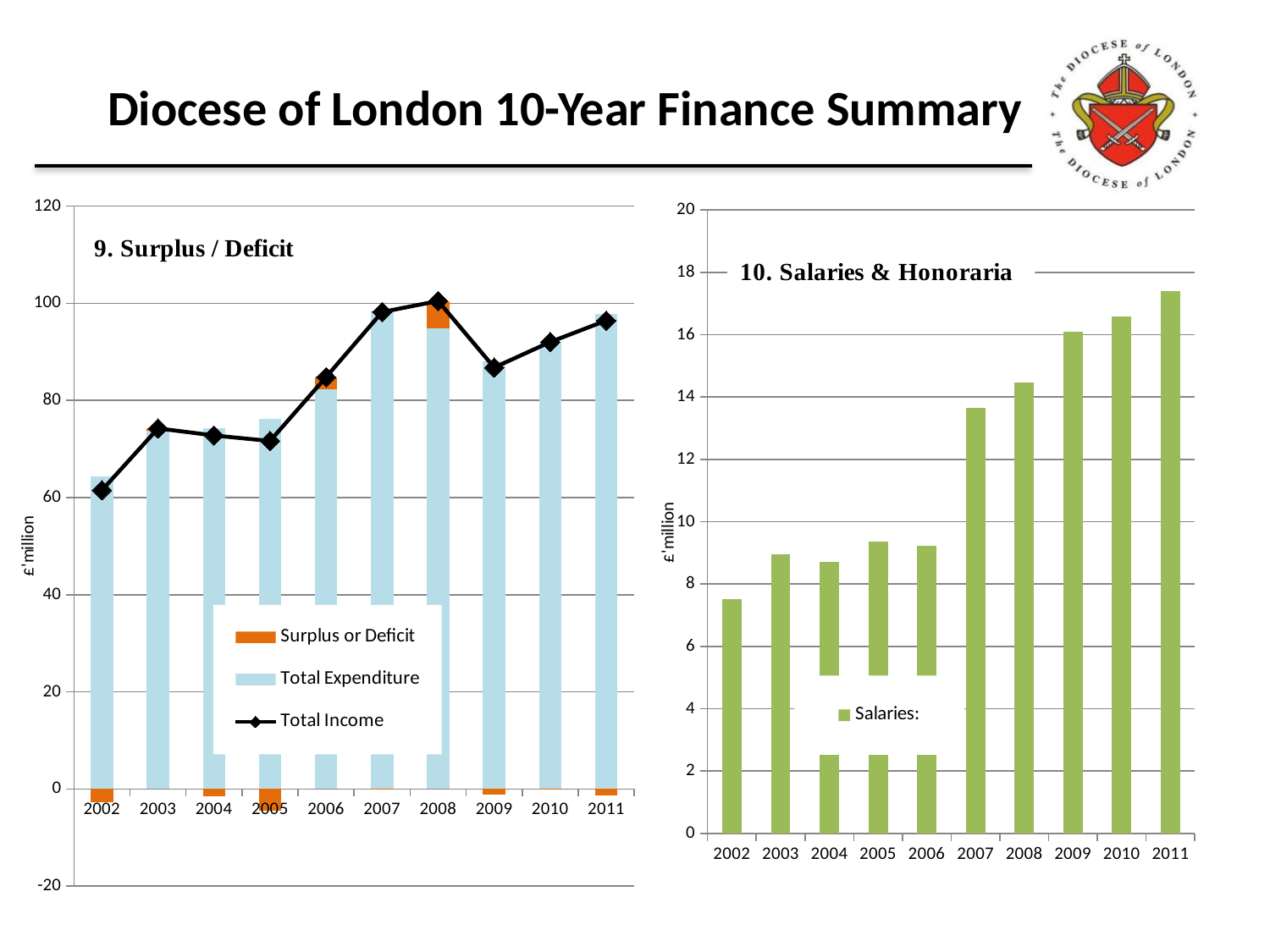
In the '10. Salaries & Honoraria' chart, is the value for 2007 greater or less than 12? greater What kind of chart is '10. Salaries & Honoraria'? bar chart How many years are shown on the x axis of the '10. Salaries & Honoraria' chart? 10 In the '10. Salaries & Honoraria' chart, which year has the lowest salaries value? 2002 In the '10. Salaries & Honoraria' chart, do the values generally rise or fall from 2002 to 2011? rise In the '9. Surplus / Deficit' chart, is the Total Income for 2007 greater or less than 80? greater In the '10. Salaries & Honoraria' chart, is the value for 2011 greater or less than 16? greater How many series does the legend of the '9. Surplus / Deficit' chart list? 3 In the '9. Surplus / Deficit' chart, which year has the lowest Total Income? 2002 In the '10. Salaries & Honoraria' chart, which year has the highest salaries value? 2011 In the '10. Salaries & Honoraria' chart, which is larger, the value for 2006 or the value for 2009? 2009